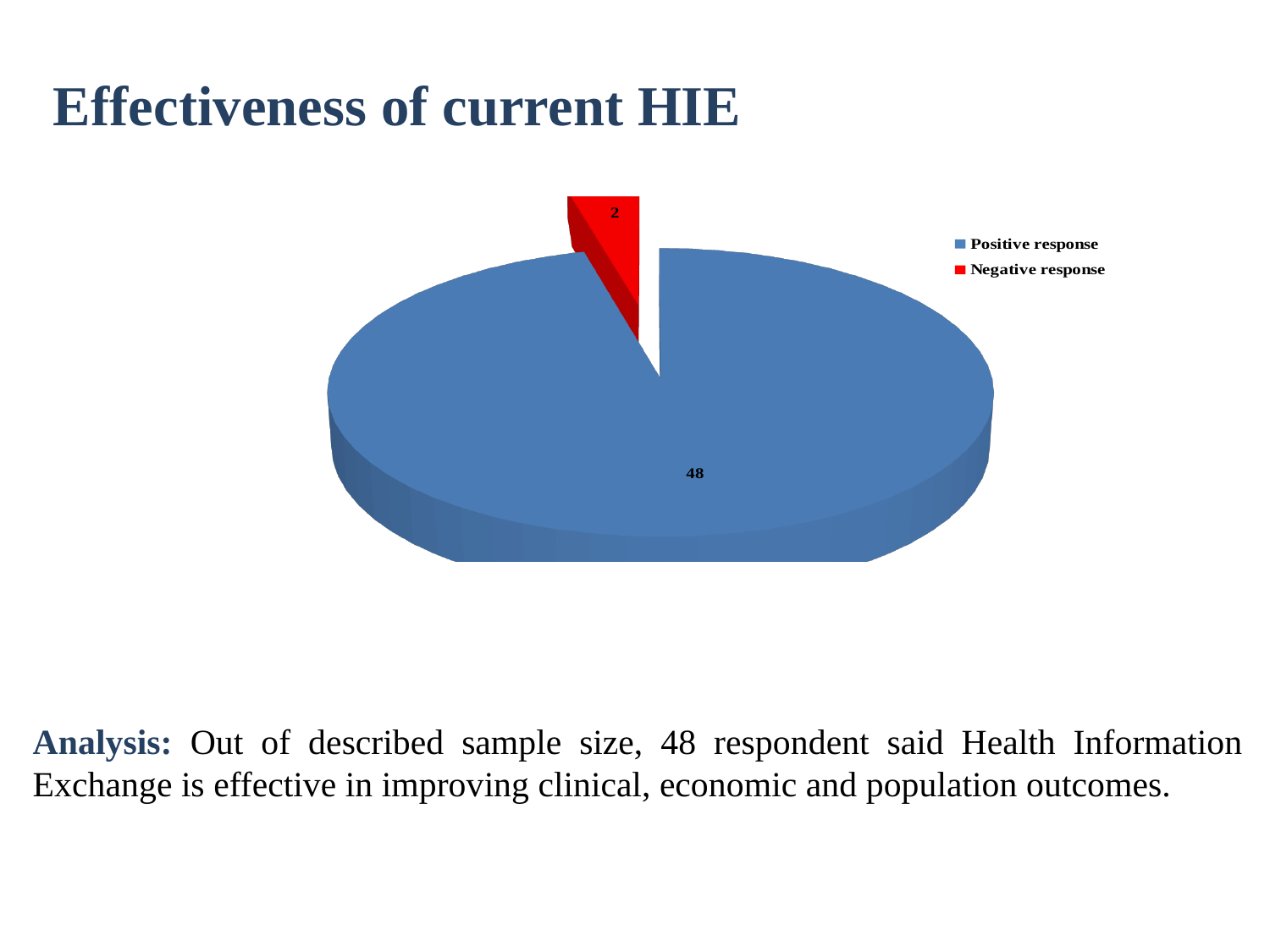
Which is larger, Positive response or Negative response? Positive response Which category has the largest slice? Positive response What is the difference between the Positive response and Negative response values? 46 What is the value for Negative response? 2 What is the total of all slices in the pie chart? 50 What share of the pie does Negative response represent? 4% What colour is the Negative response slice? red How many entries does the legend list? 2 How many slices does the pie chart have? 2 Which category has the smallest slice? Negative response What kind of chart is shown on the slide? pie chart What is the value for Positive response? 48